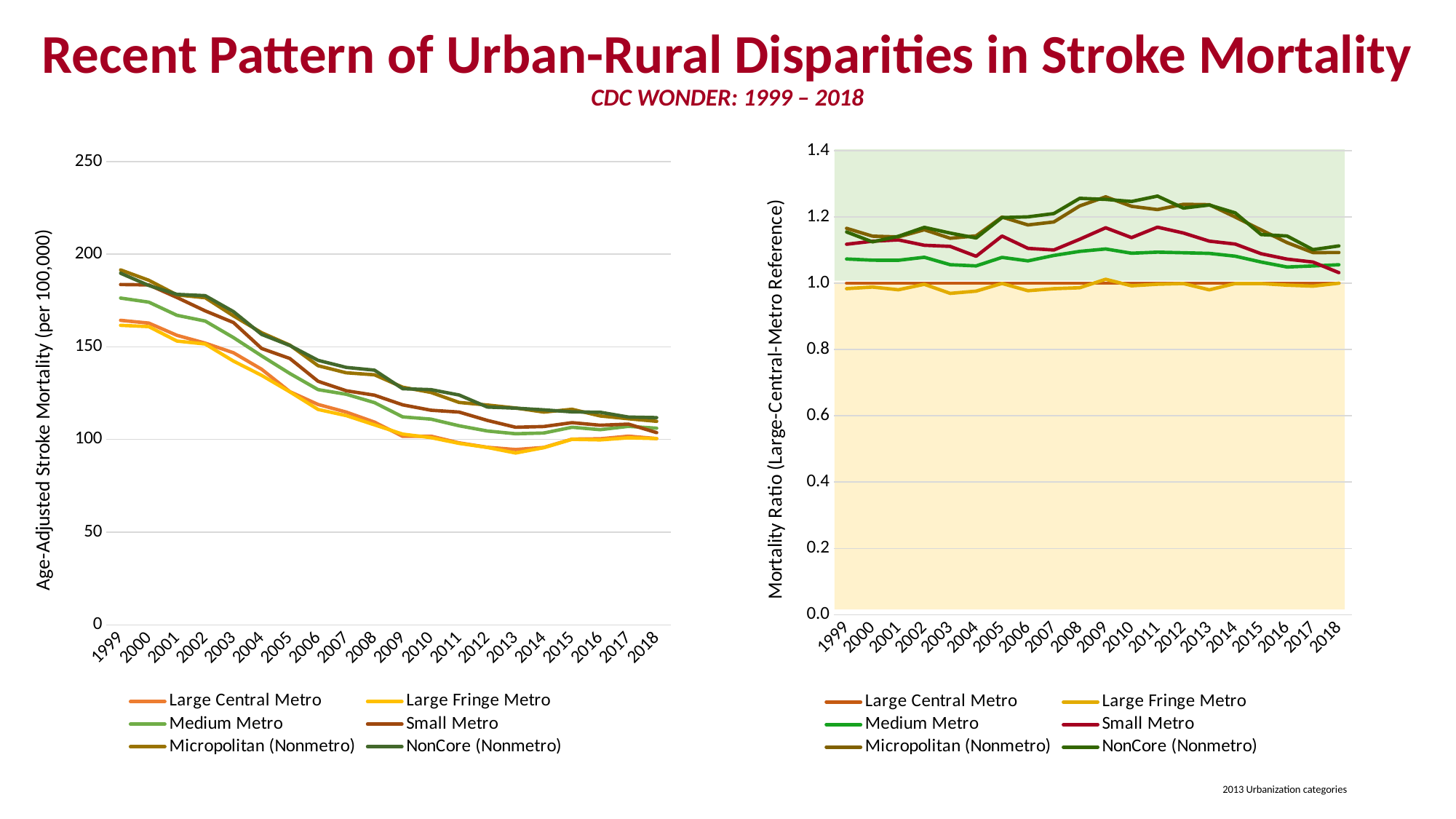
How many years are plotted along the x axis of the right chart? 20 In the left chart, do the Age-Adjusted Stroke Mortality values for Medium Metro rise or fall from 1999 to 2018? fall In the left chart, is the value for Large Central Metro in 1999 greater or less than 150? greater In the left chart, which is higher in 2010, Small Metro or Large Fringe Metro? Small Metro In the right chart, which series has the lowest Mortality Ratio in 2003? Large Fringe Metro How many series does the legend of the left chart list? 6 In the right chart, is the Mortality Ratio for NonCore (Nonmetro) in 2009 greater or less than 1.2? greater What is the y-axis label of the right chart? Mortality Ratio (Large-Central-Metro Reference) What kind of chart is the left chart on the slide? line chart In the left chart, is the value for NonCore (Nonmetro) in 2018 greater or less than 150? less In the right chart, which series has the highest Mortality Ratio in 2011? NonCore (Nonmetro)